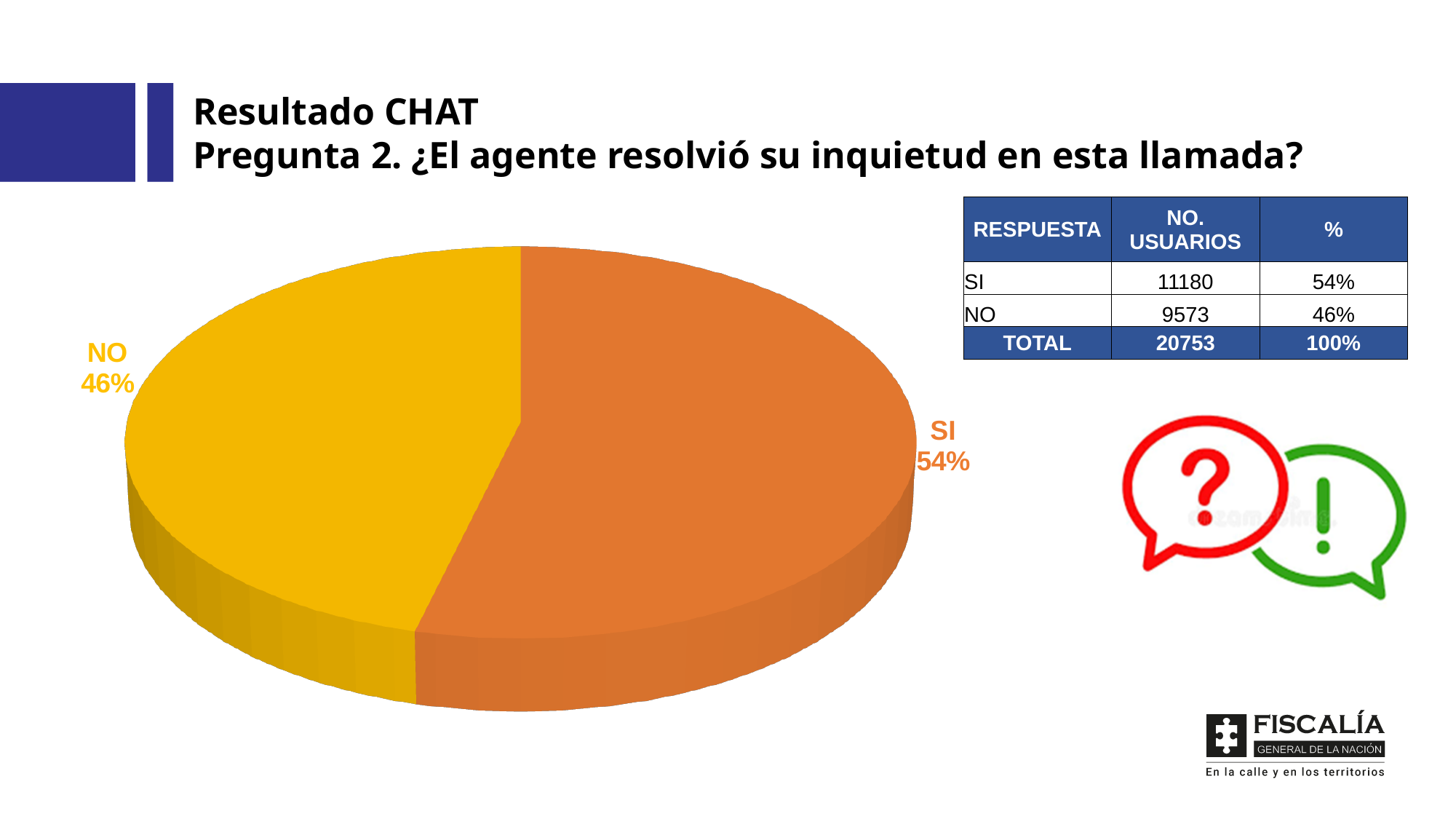
What kind of chart is shown on the slide? pie chart Is the share of the SI slice greater or less than 50%? greater Which slice of the pie chart is the smallest? NO How many slices does the pie chart have? 2 Which is larger in the pie chart, SI or NO? SI What percentage does the SI slice of the pie chart show? 54% Is the share of the NO slice greater or less than 50%? less What is the difference in percentage points between the SI and NO slices? 8 What colour is the NO slice of the pie chart? yellow Which slice of the pie chart is the largest? SI What colour is the SI slice of the pie chart? orange What percentage does the NO slice of the pie chart show? 46%